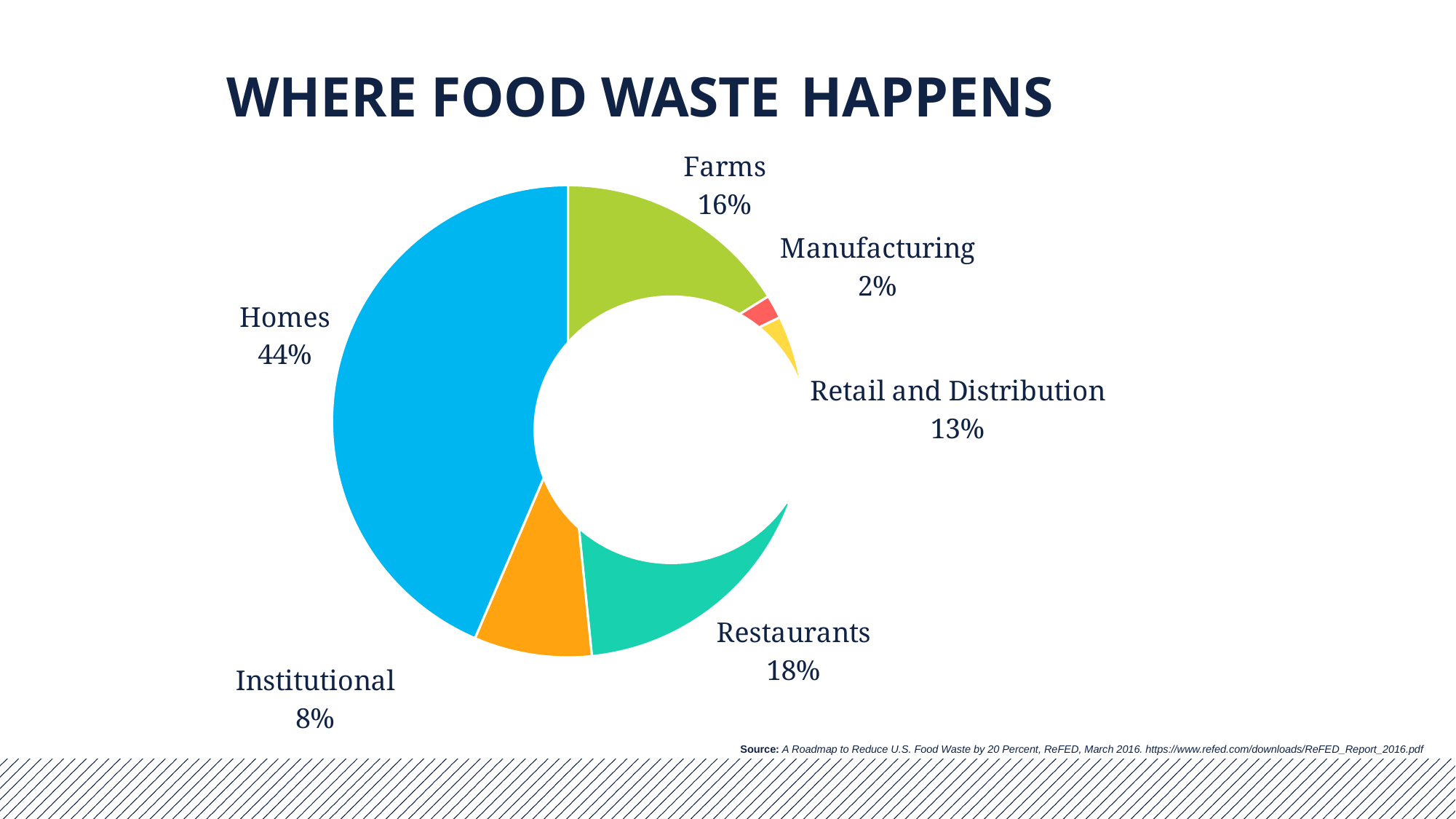
Which category accounts for the smallest share of food waste? Manufacturing What is the title of the slide? WHERE FOOD WASTE HAPPENS What percentage of food waste is attributed to Restaurants? 18% Which is larger, the share for Restaurants or the share for Retail and Distribution? Restaurants What is the difference in percentage points between Farms and Institutional? 8 How many percentage points higher is Homes than Restaurants? 26 What percentage of food waste happens at Farms? 16% What share of food waste happens in Homes? 44% How many categories are shown in the chart? 6 What kind of chart is shown on the slide? Doughnut (pie) chart What is the value shown for Retail and Distribution? 13% Which category accounts for the largest share of food waste? Homes